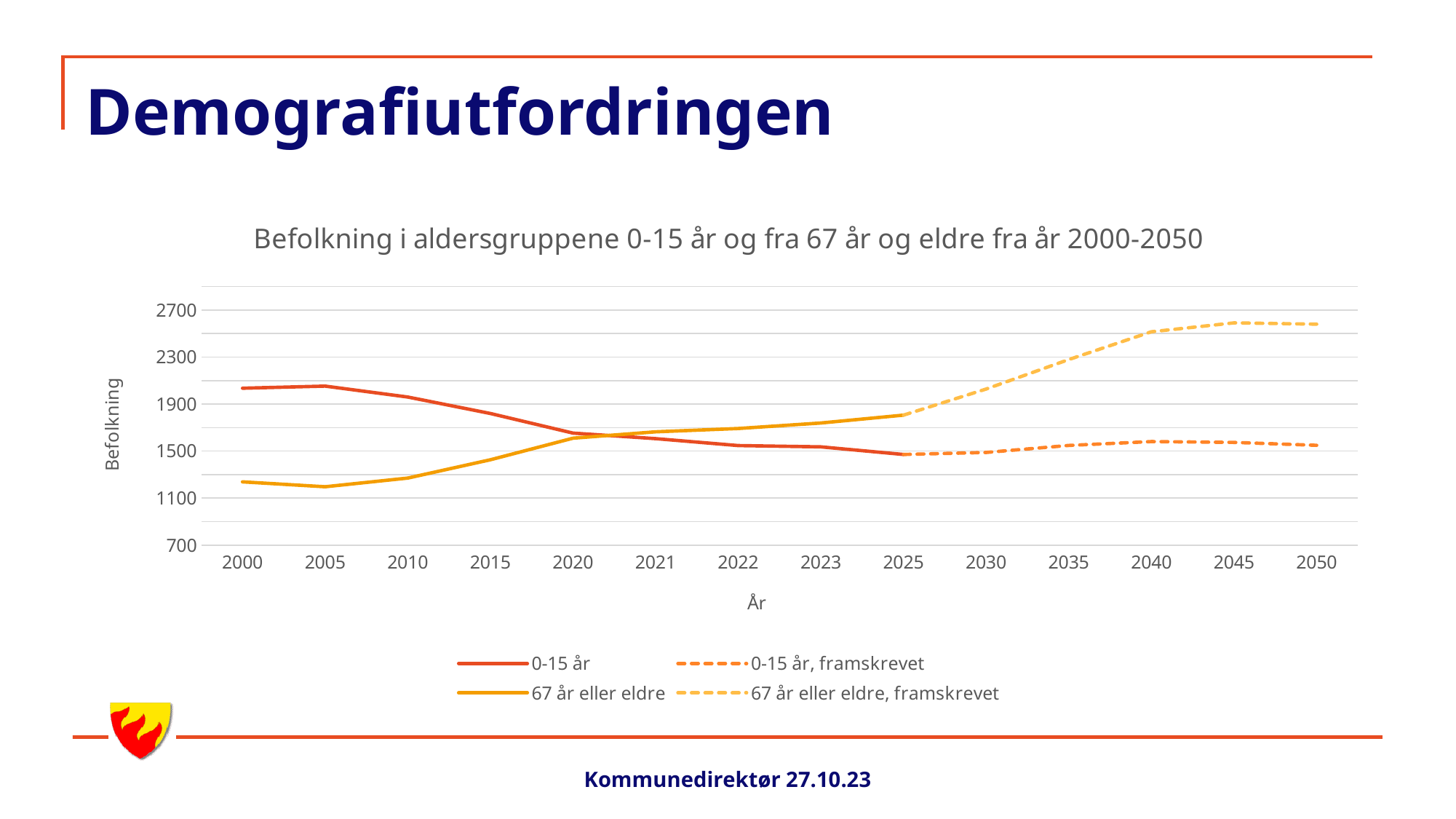
Is the value for 67 år eller eldre, framskrevet in 2050 greater or less than 2300? greater What is the title of the chart? Befolkning i aldersgruppene 0-15 år og fra 67 år og eldre fra år 2000-2050 In 2000, which is larger: the value for 0-15 år or the value for 67 år eller eldre? 0-15 år What kind of chart is shown on the slide? line chart Is the value for 0-15 år, framskrevet in 2050 greater or less than 1900? less Does the 67 år eller eldre series rise or fall from 2005 to 2025? rise Is the value for 0-15 år in 2000 greater or less than 1900? greater In 2050, which is larger: the value for 0-15 år, framskrevet or the value for 67 år eller eldre, framskrevet? 67 år eller eldre, framskrevet How many series does the legend list? 4 What is the label of the y axis? Befolkning How many years are marked on the x axis? 14